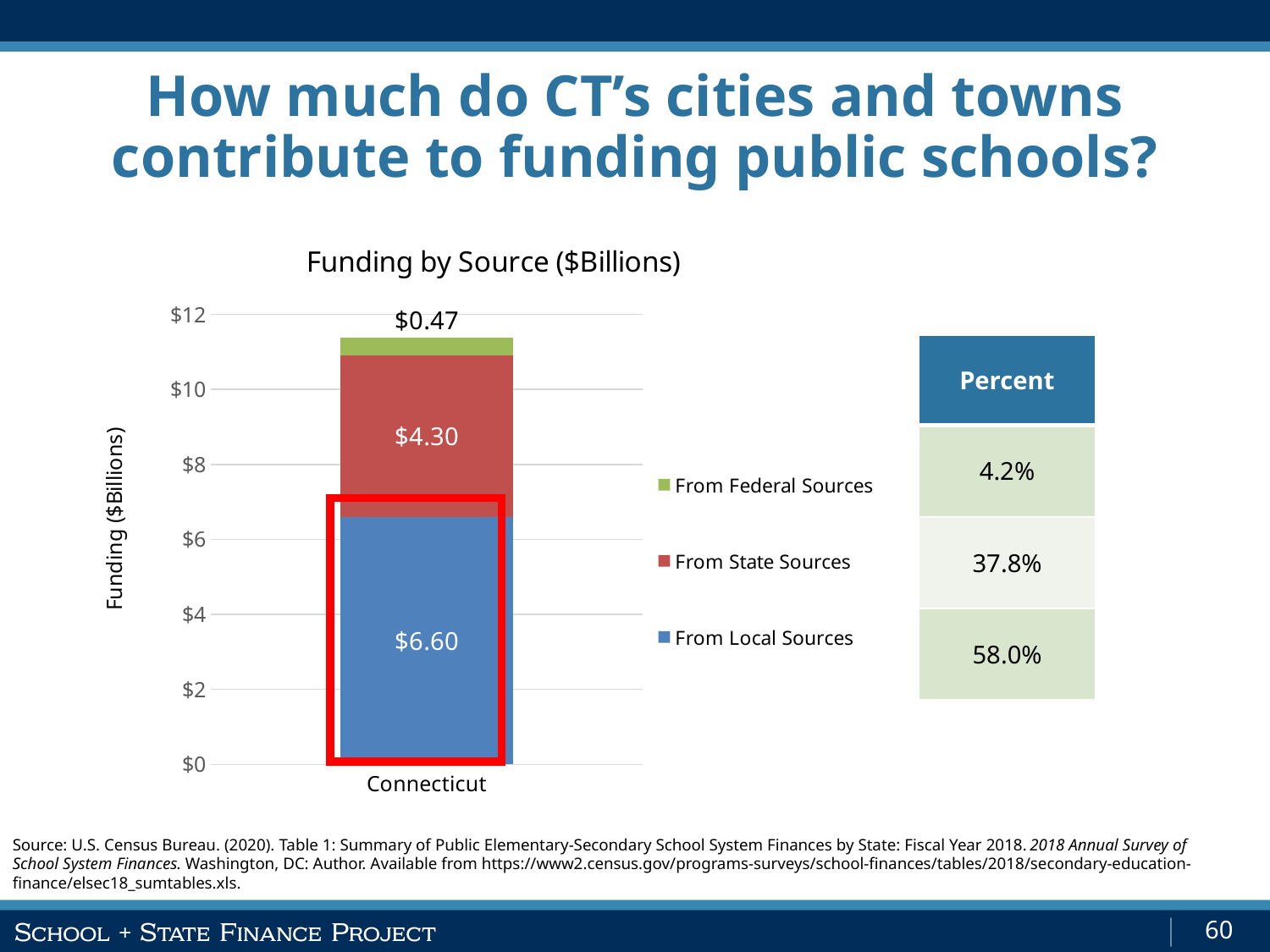
What is the title of the chart on the slide? Funding by Source ($Billions) What is the difference between the From Local Sources and From State Sources values in the Funding by Source chart? $2.30 What is the value for From Local Sources in the Funding by Source chart? $6.60 What is the total of the stacked bar for Connecticut in the Funding by Source chart? $11.37 How many series does the legend of the Funding by Source chart list? 3 What is the value for From State Sources in the Funding by Source chart? $4.30 Which is larger in the Funding by Source chart, From State Sources or From Federal Sources? From State Sources What is the value for From Federal Sources in the Funding by Source chart? $0.47 Which funding source has the largest value in the Funding by Source chart? From Local Sources What kind of chart is the Funding by Source chart? Stacked bar chart Which funding source has the smallest value in the Funding by Source chart? From Federal Sources Is the total height of the Connecticut bar greater or less than $10? greater